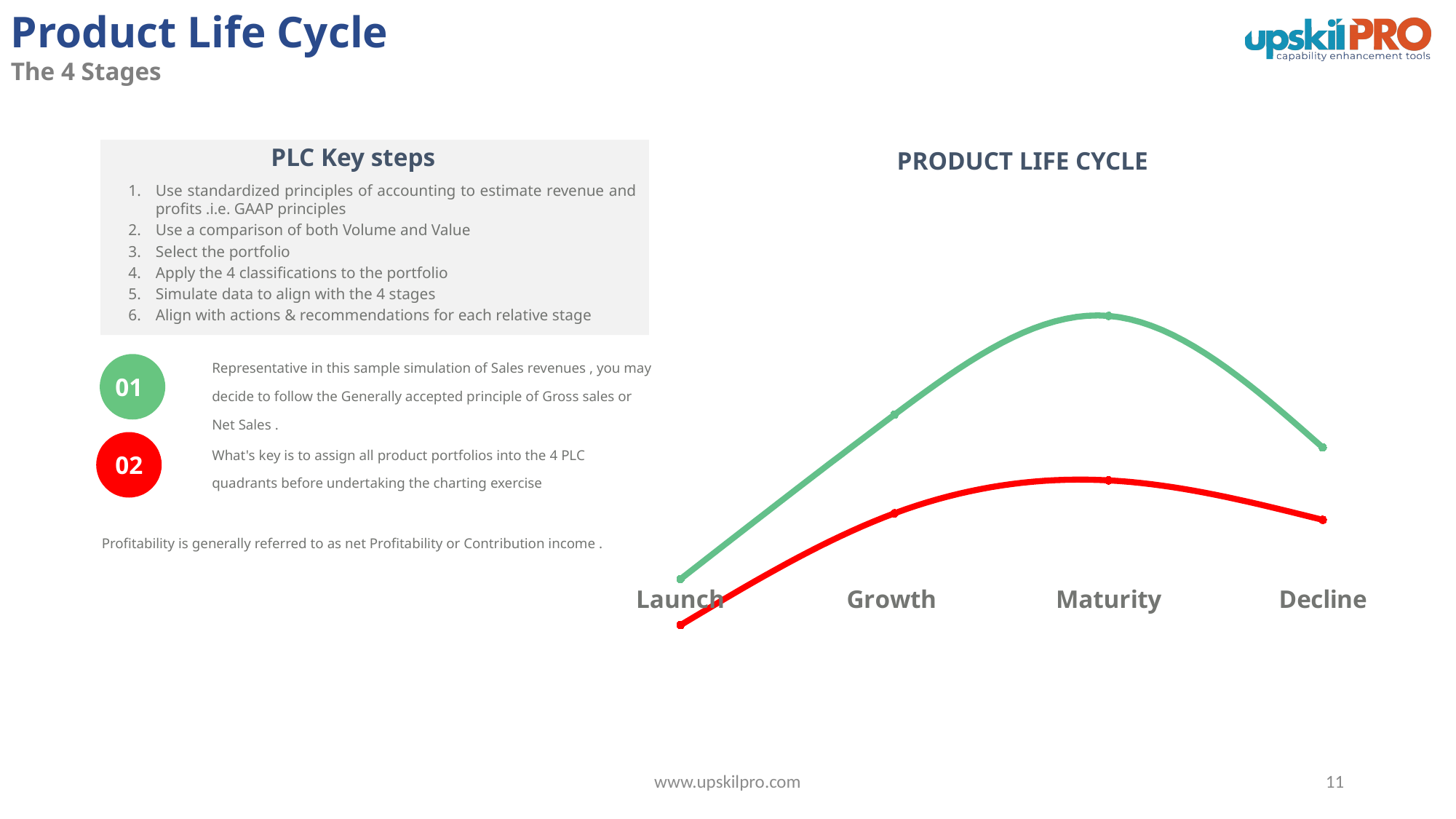
At which stage does the green line reach its highest point? Maturity Does the red line rise or fall between Launch and Growth? rise Which line is higher at the Maturity stage, the green line or the red line? green line Does the green line rise or fall between Maturity and Decline? fall At which stage is the green line at its lowest point? Launch How many lines are plotted on the chart? 2 How many stages are labelled along the x axis of the chart? 4 What kind of chart is shown on the slide? line chart At which stage is the red line at its lowest point? Launch What is the title of the chart? PRODUCT LIFE CYCLE At which stage does the red line reach its highest point? Maturity What are the colours of the two lines on the chart? green and red